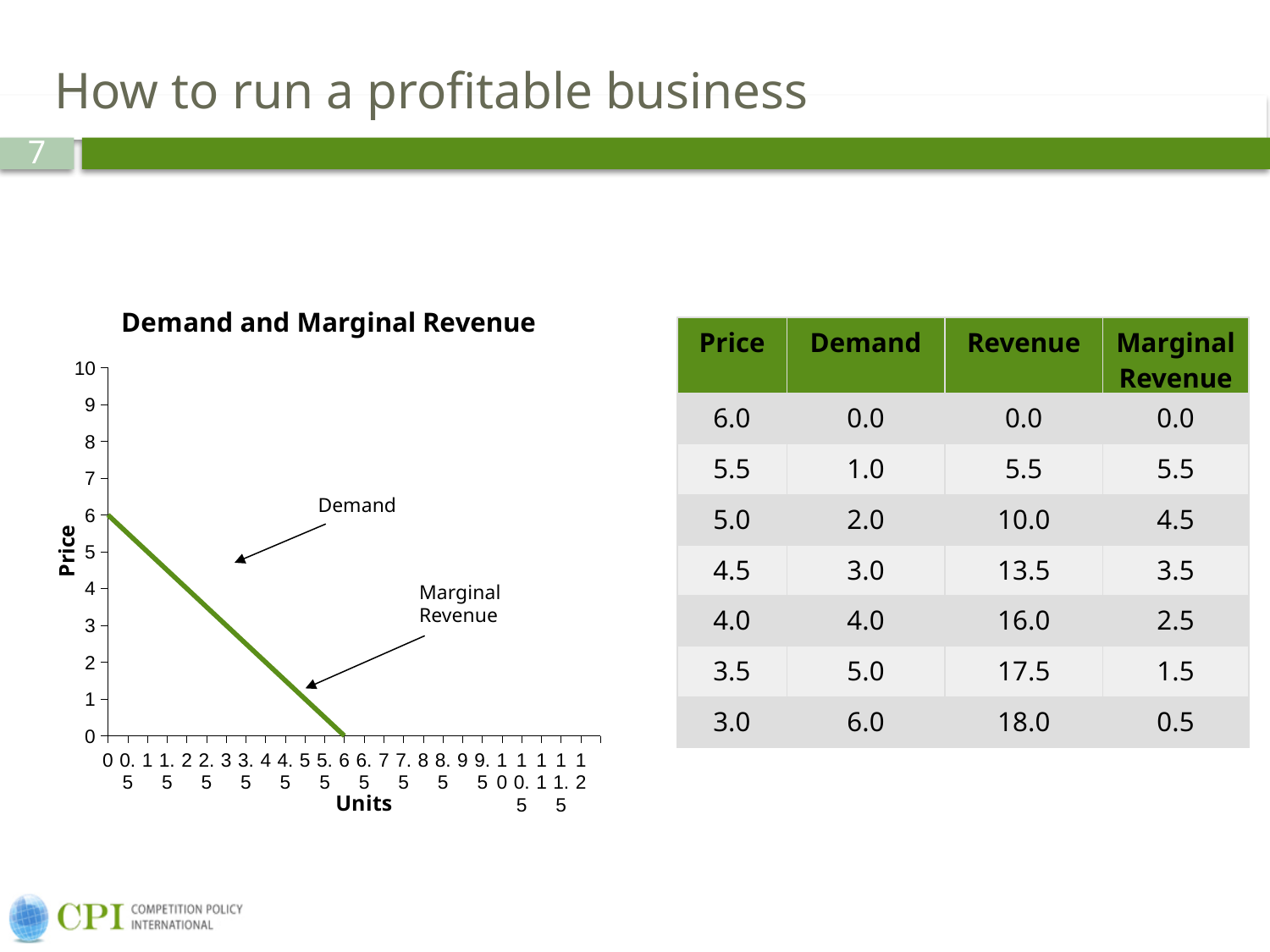
Is the Price on the line at 4 Units greater or less than 3? less What is the label on the vertical axis of the chart? Price What is the title of the chart? Demand and Marginal Revenue Is the Price on the line at 1 Unit greater or less than 4? greater Does the plotted line rise or fall as Units increase along the x axis? fall Is the Price on the line at 5 Units greater or less than 2? less What is the highest value shown on the Price axis? 10 What is the Price value where the line meets the vertical axis at 0 Units? 6 At how many Units does the line reach a Price of 0? 6 What type of chart is shown on the slide? line chart